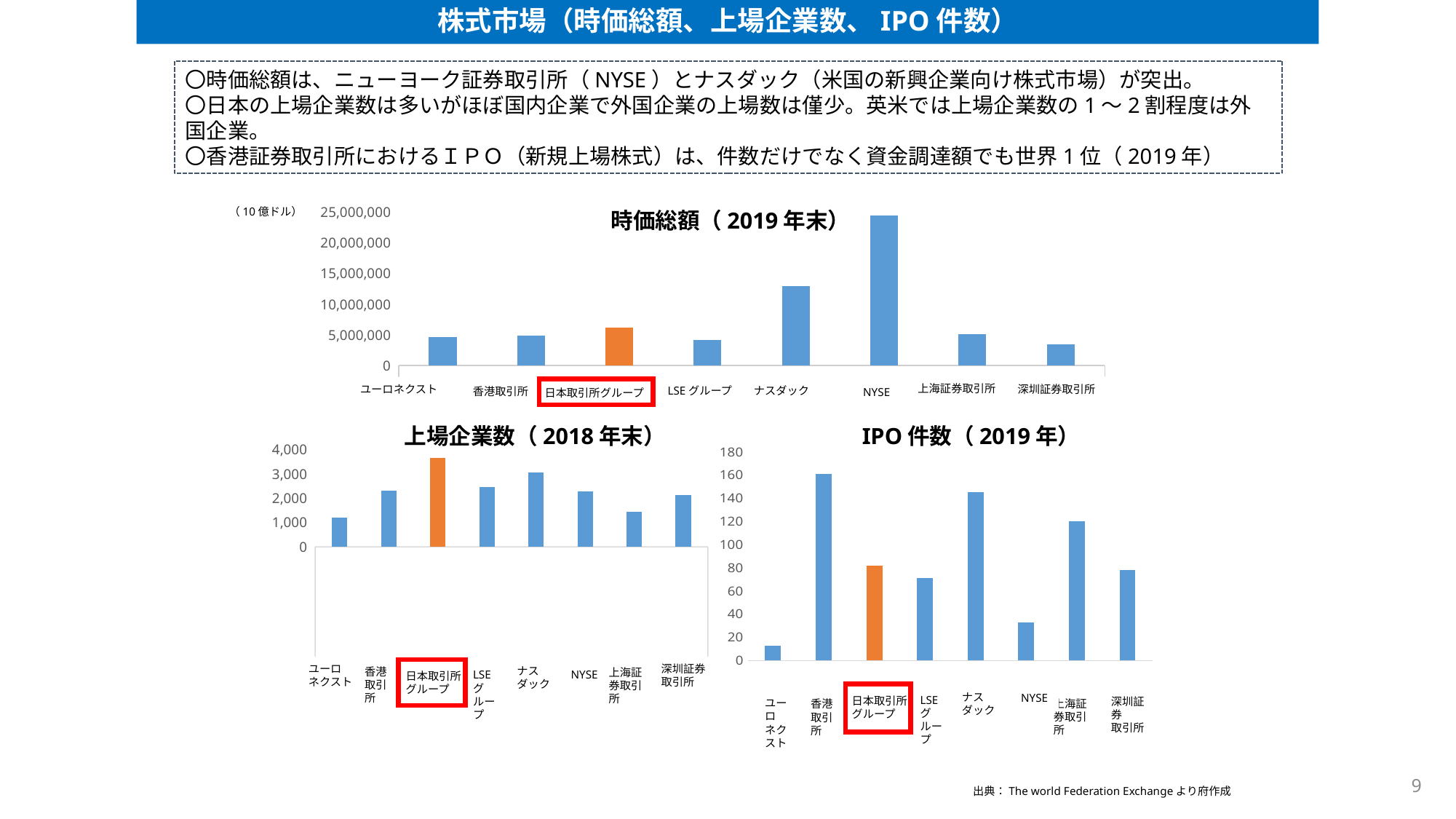
In the 時価総額（2019年末） chart, is the value for NYSE greater or less than 20,000,000? greater In the 上場企業数（2018年末） chart, which exchange has the lowest number of listed companies? ユーロネクスト In the 上場企業数（2018年末） chart, which is larger, the value for ナスダック or the value for LSEグループ? ナスダック In the IPO件数（2019年） chart, which exchange has the highest number of IPOs? 香港取引所 In the 時価総額（2019年末） chart, how many exchanges are plotted? 8 In the 上場企業数（2018年末） chart, which exchange has the highest number of listed companies? 日本取引所グループ In the 時価総額（2019年末） chart, which exchange has the lowest market capitalization? 深圳証券取引所 In the IPO件数（2019年） chart, is the value for NYSE greater or less than 40? less In the 時価総額（2019年末） chart, is the value for ナスダック greater or less than 10,000,000? greater What kind of chart is the IPO件数（2019年） chart? bar chart In the IPO件数（2019年） chart, which exchange has the lowest number of IPOs? ユーロネクスト In the 時価総額（2019年末） chart, which exchange has the highest market capitalization? NYSE